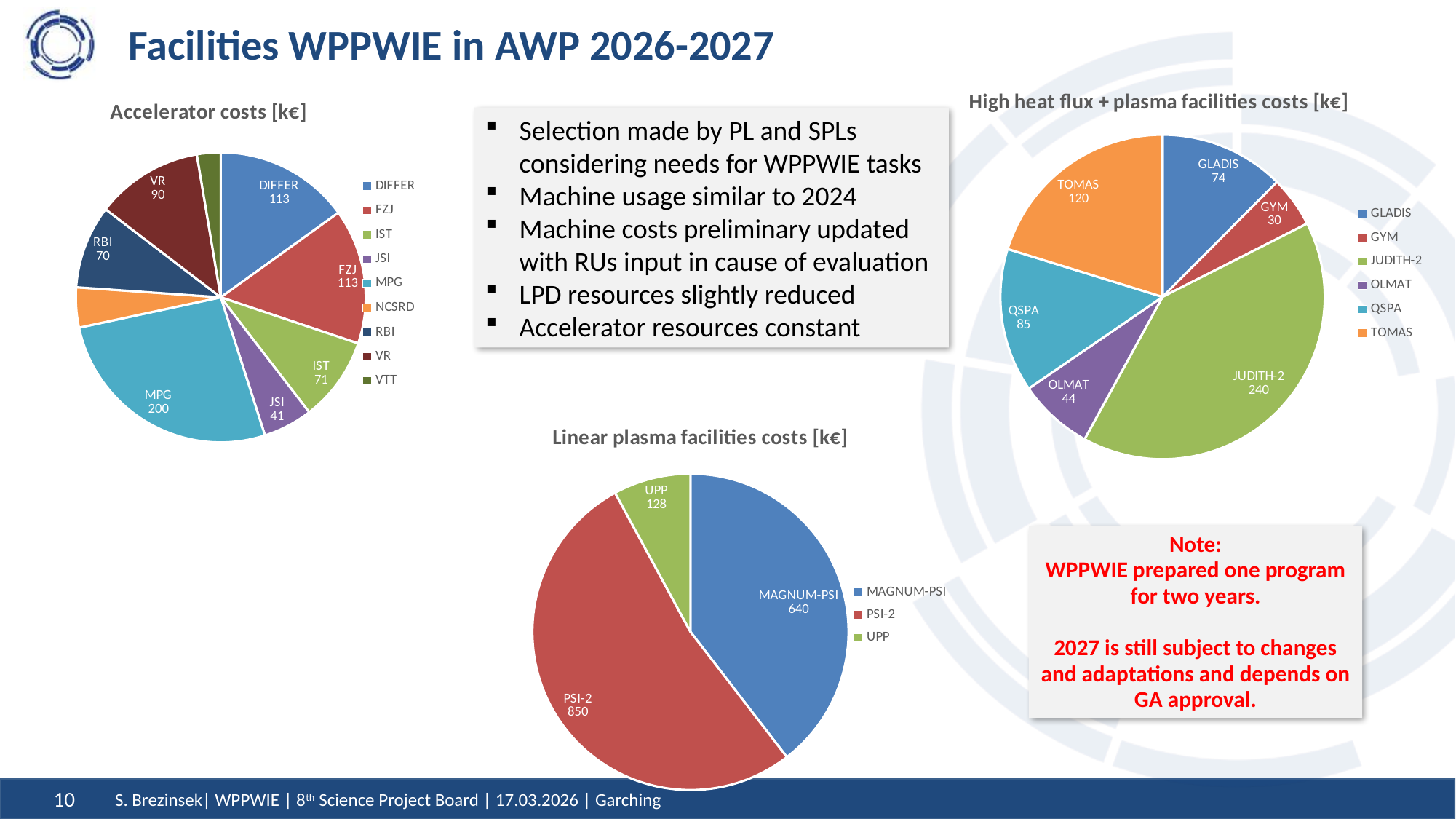
In the High heat flux + plasma facilities costs chart, what is the difference between TOMAS and QSPA? 35 What type of chart is the Linear plasma facilities costs chart? Pie chart In the Accelerator costs chart, which category has the largest slice? MPG In the Accelerator costs chart, what is the value for MPG? 200 In the Linear plasma facilities costs chart, what is the difference between PSI-2 and MAGNUM-PSI? 210 In the High heat flux + plasma facilities costs chart, how many categories are shown? 6 In the Linear plasma facilities costs chart, what is the value for PSI-2? 850 In the High heat flux + plasma facilities costs chart, which category has the smallest value? GYM In the Accelerator costs chart, what is the difference between the values for VR and RBI? 20 In the High heat flux + plasma facilities costs chart, what is the value for JUDITH-2? 240 In the Accelerator costs chart, how many entries does the legend list? 9 In the Accelerator costs chart, which is larger, IST or JSI? IST